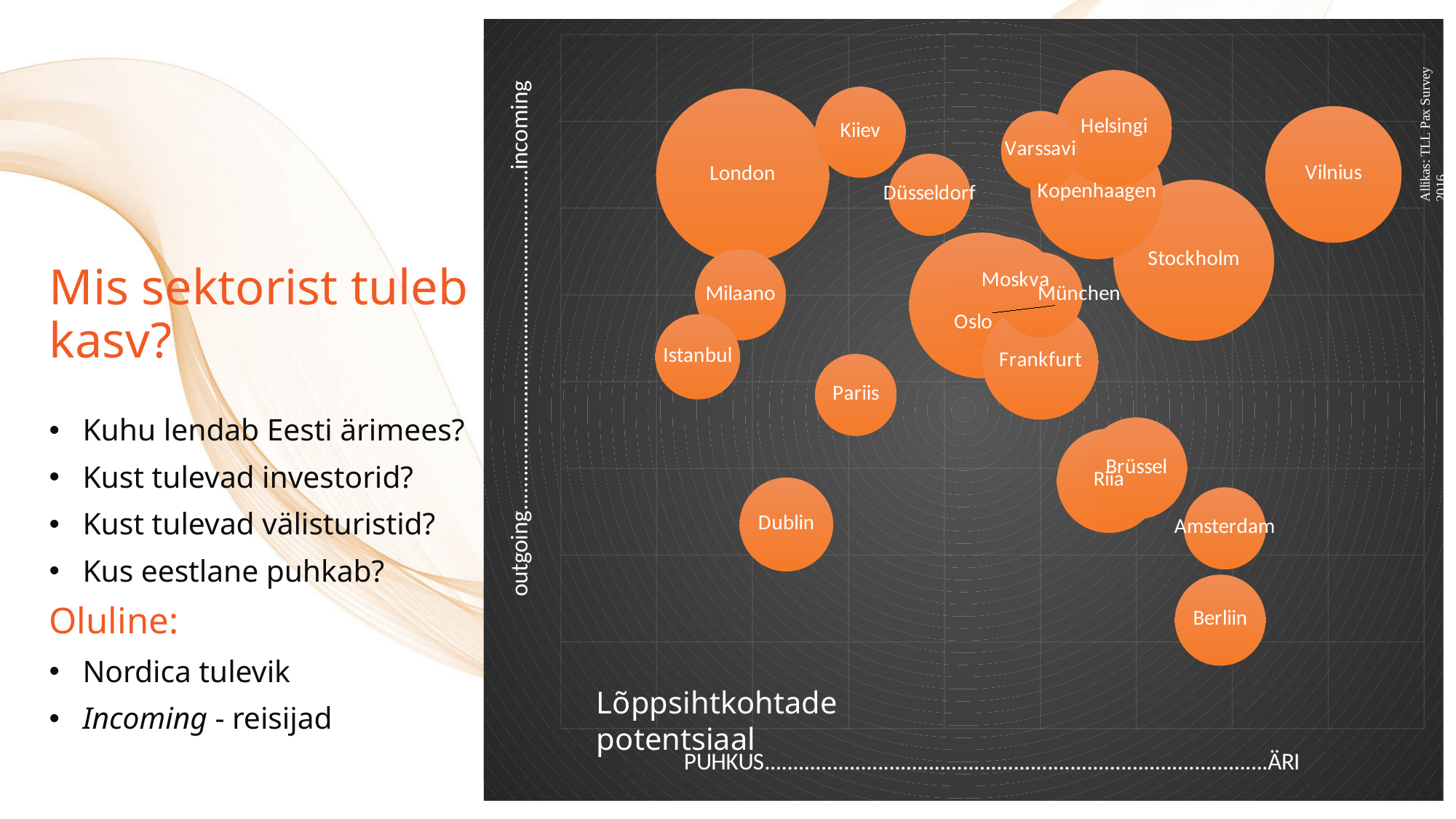
What are the two labels at the ends of the horizontal axis? PUHKUS and ÄRI Which city has the largest bubble on the chart? London Which bubble is positioned further toward the incoming end of the vertical axis, London or Dublin? London Which bubble is positioned further toward the PUHKUS end of the horizontal axis, Istanbul or Amsterdam? Istanbul What is the title of the chart? Lõppsihtkohtade potentsiaal Which bubble is larger, Stockholm or Pariis? Stockholm How many city bubbles are plotted on the chart? 20 What kind of chart is shown on the slide? bubble chart